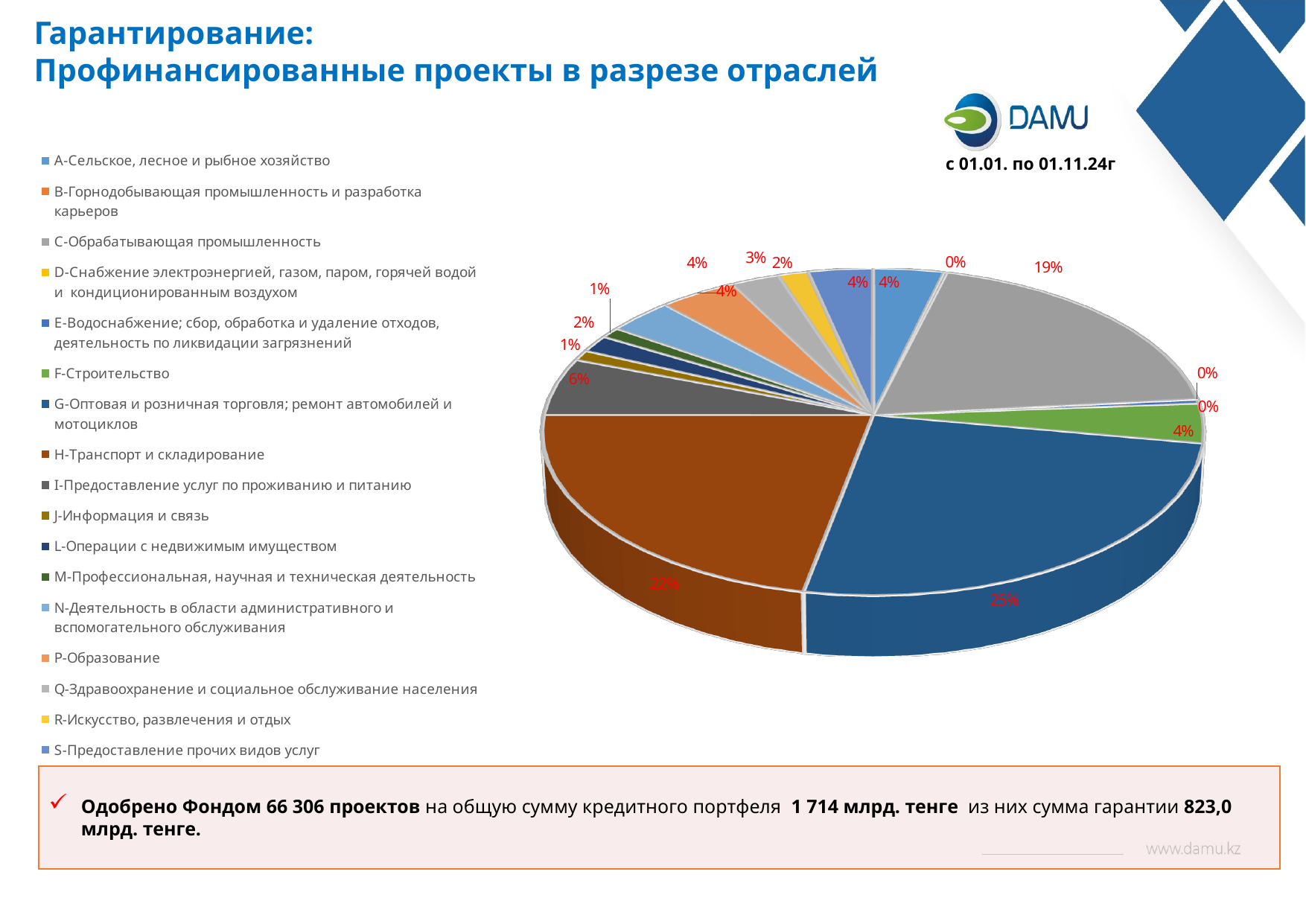
How many categories does the legend list? 17 What is the value shown for I-Предоставление услуг по проживанию и питанию? 6% Which is larger: the share for C-Обрабатывающая промышленность or the share for H-Транспорт и складирование? H-Транспорт и складирование What share of the pie does G-Оптовая и розничная торговля; ремонт автомобилей и мотоциклов have? 25% What is the value shown for C-Обрабатывающая промышленность? 19% What is the difference in percentage points between G-Оптовая и розничная торговля and H-Транспорт и складирование? 3 percentage points What kind of chart is shown on the slide? pie chart What is the value shown for H-Транспорт и складирование? 22% What is the value shown for F-Строительство? 4% What is the title of the slide? Гарантирование: Профинансированные проекты в разрезе отраслей Which category has the largest share of the pie? G-Оптовая и розничная торговля; ремонт автомобилей и мотоциклов What period does the chart cover, according to the text above it? с 01.01. по 01.11.24г